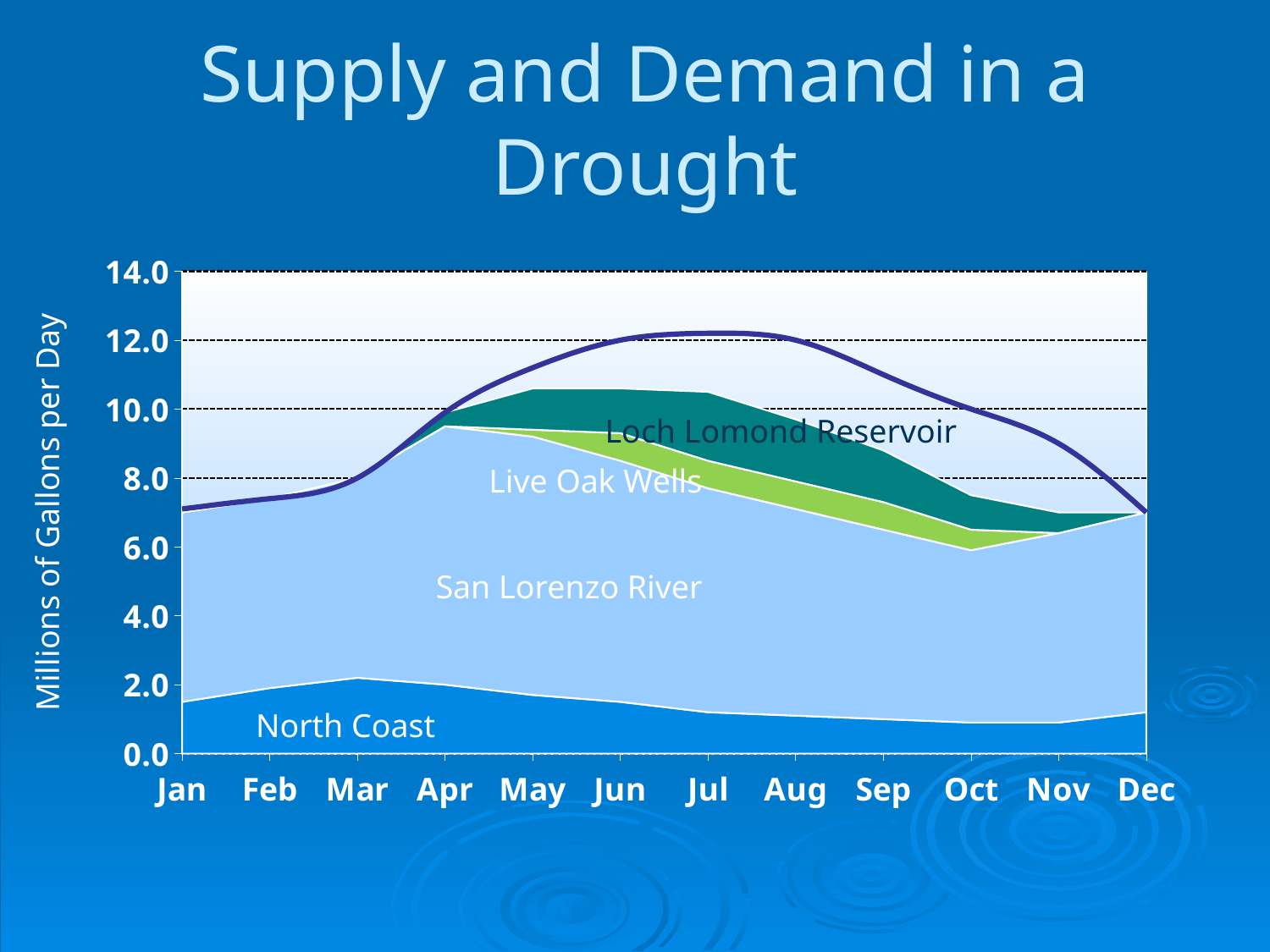
Does the dark line rise or fall from Jan to Jul? rise Is the North Coast value in Jul greater or less than 2.0? less How many supply sources are labelled as areas in the chart? 4 Is the total stacked supply in Oct greater or less than 8.0? less What is the label on the y axis? Millions of Gallons per Day Is the value of the dark line in Jul greater or less than 12.0? greater What is the title of the chart? Supply and Demand in a Drought What kind of chart is shown on the slide? Stacked area chart with a line How many months are shown along the x axis? 12 Which is larger, the dark line value in Jul or in Jan? Jul